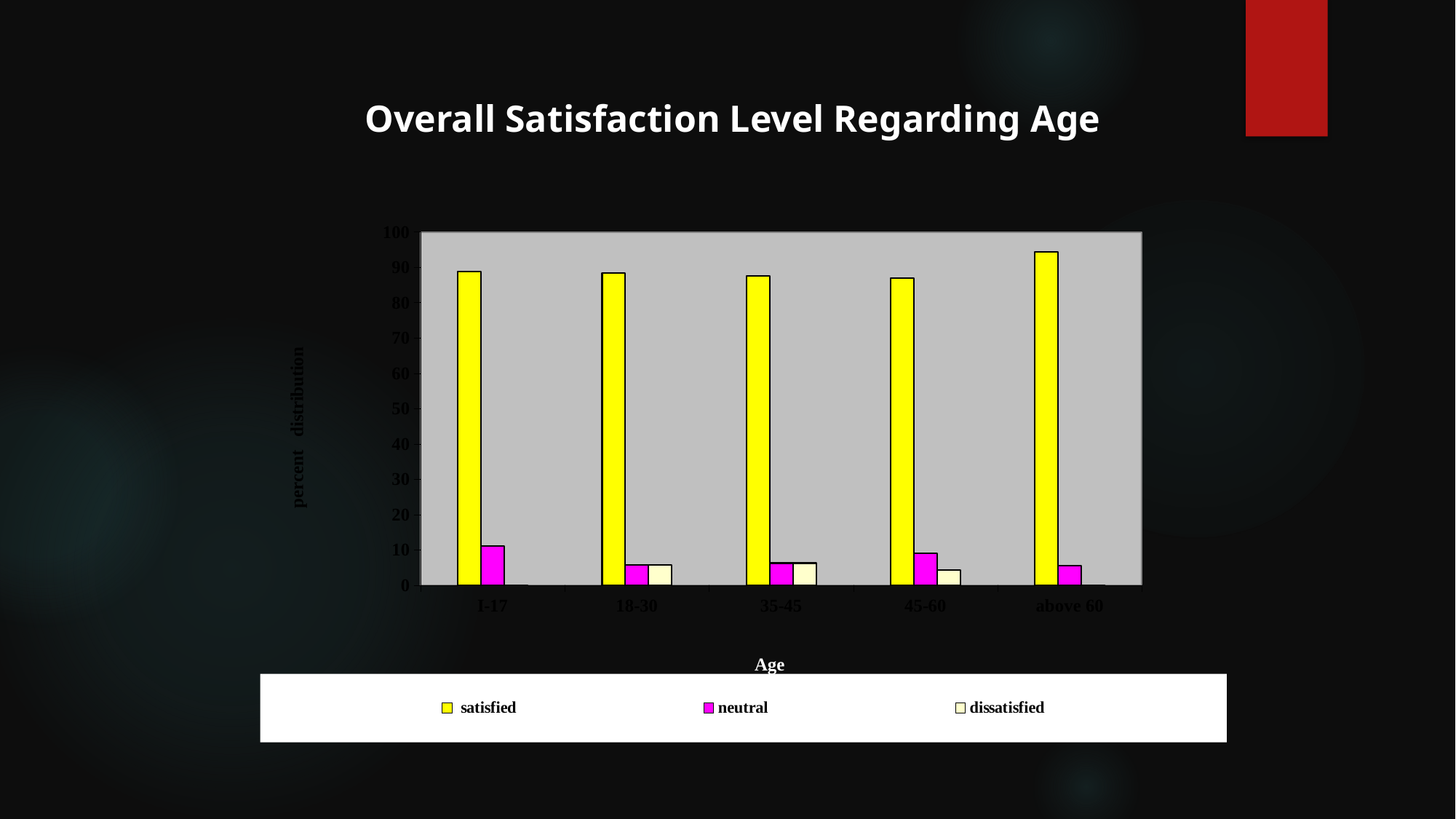
Which age group has the highest neutral value? I-17 What kind of chart is shown on the slide? bar chart Is the neutral value for 1-17 greater or less than 10? greater How many series does the legend list? 3 Is the satisfied value for above 60 greater or less than 90? greater Is the dissatisfied value for 45-60 greater or less than 10? less For the 45-60 age group, which is larger, the neutral value or the dissatisfied value? neutral Which age group has the highest satisfied value? above 60 Which is larger, the satisfied value for above 60 or the satisfied value for 1-17? above 60 How many age groups are shown on the x axis? 5 What is the label on the y axis of the chart? percent distribution